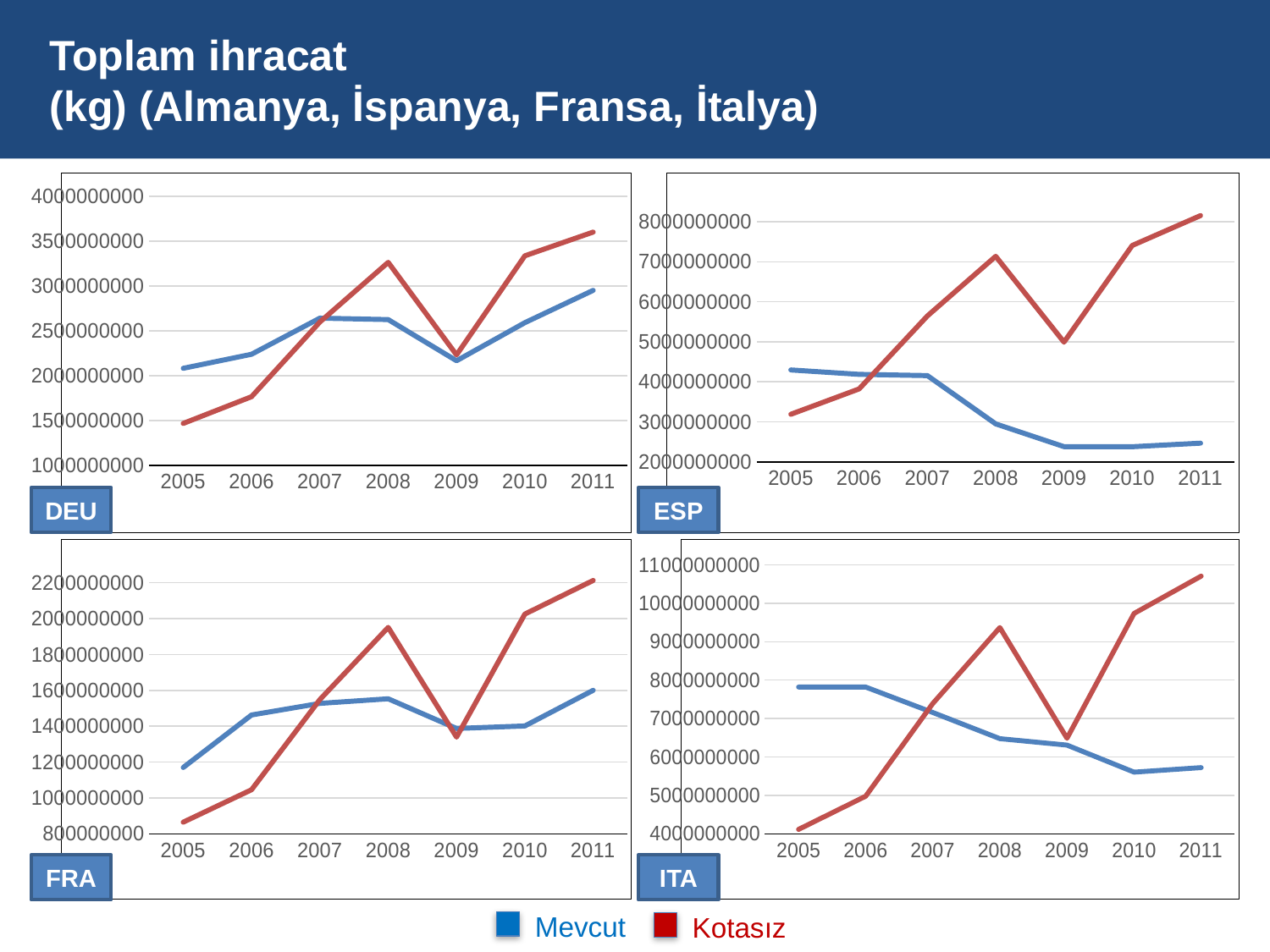
How many years are plotted on the x axis of the FRA chart? 7 In the DEU chart, is the Kotasız value for 2008 greater or less than 3000000000? greater In the ESP chart, which year has the highest Kotasız value? 2011 In the ESP chart, is the Mevcut value for 2009 greater or less than 3000000000? less How many series does the legend at the bottom of the slide list? 2 What kind of chart is the DEU chart? line chart In the ITA chart, does the Mevcut series overall rise or fall from 2005 to 2011? fall In the FRA chart, is the Kotasız value for 2005 greater or less than 1000000000? less In the DEU chart, which series has the larger value in 2008, Mevcut or Kotasız? Kotasız Which colour represents the Kotasız series in the charts? red In the ESP chart, which year has the highest Mevcut value? 2005